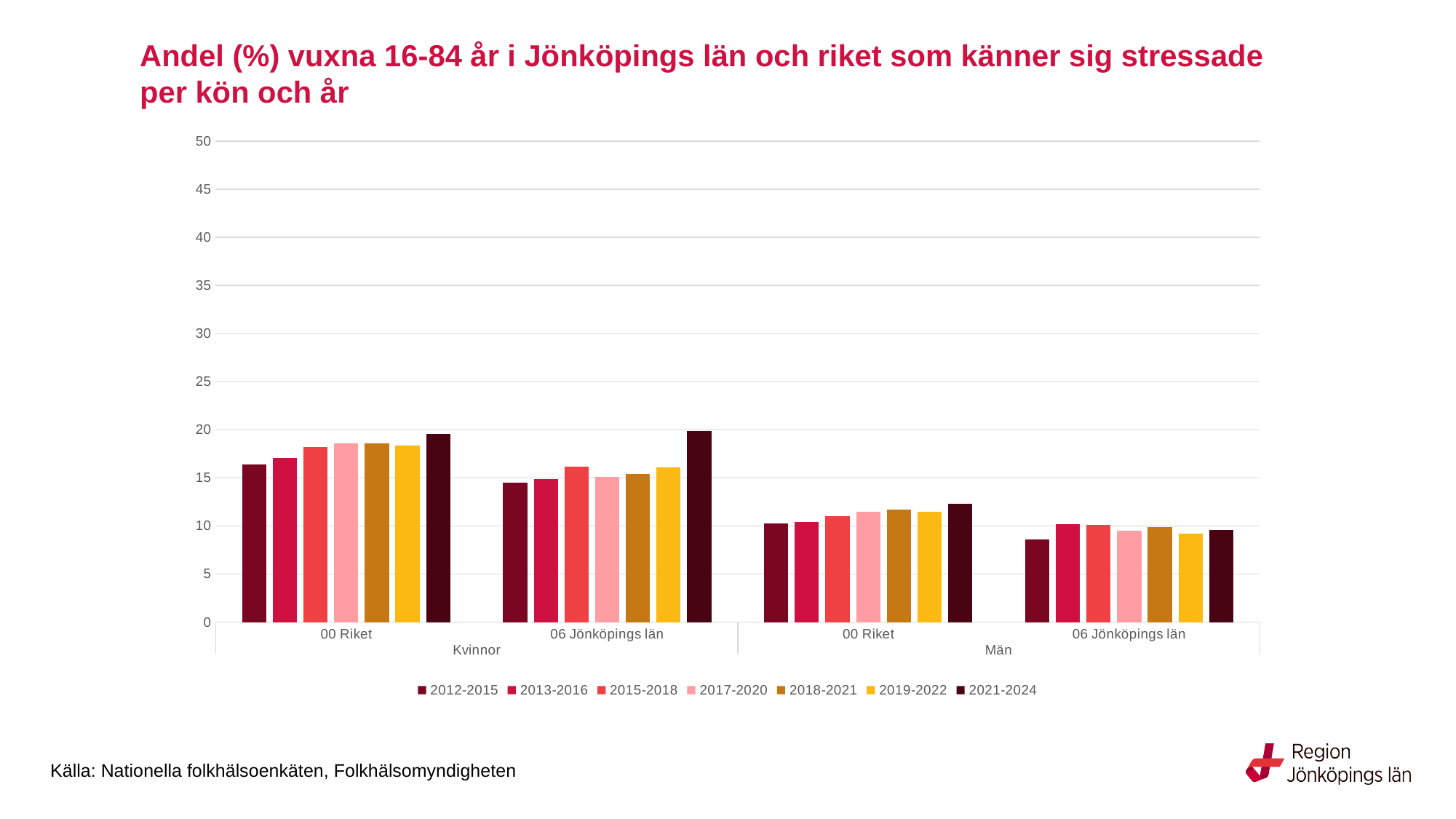
Is the value for 2021-2024 in the Män 00 Riket group greater or less than 10? greater Which period has the lowest value in the Kvinnor 00 Riket group? 2012-2015 In the Män 00 Riket group, do the values generally rise or fall from 2012-2015 to 2021-2024? rise Is the value for 2021-2024 in the Kvinnor 00 Riket group greater or less than 15? greater Which period has the lowest value in the Män 06 Jönköpings län group? 2012-2015 Is the value for 2012-2015 in the Män 06 Jönköpings län group greater or less than 10? less How many groups of bars are plotted along the x axis? 4 What kind of chart is shown on the slide? Bar chart For 2021-2024, which is larger: the Män 00 Riket value or the Män 06 Jönköpings län value? Män 00 Riket What source is cited at the bottom of the slide? Nationella folkhälsoenkäten, Folkhälsomyndigheten Which period has the highest value in the Kvinnor 06 Jönköpings län group? 2021-2024 How many series does the legend list? 7